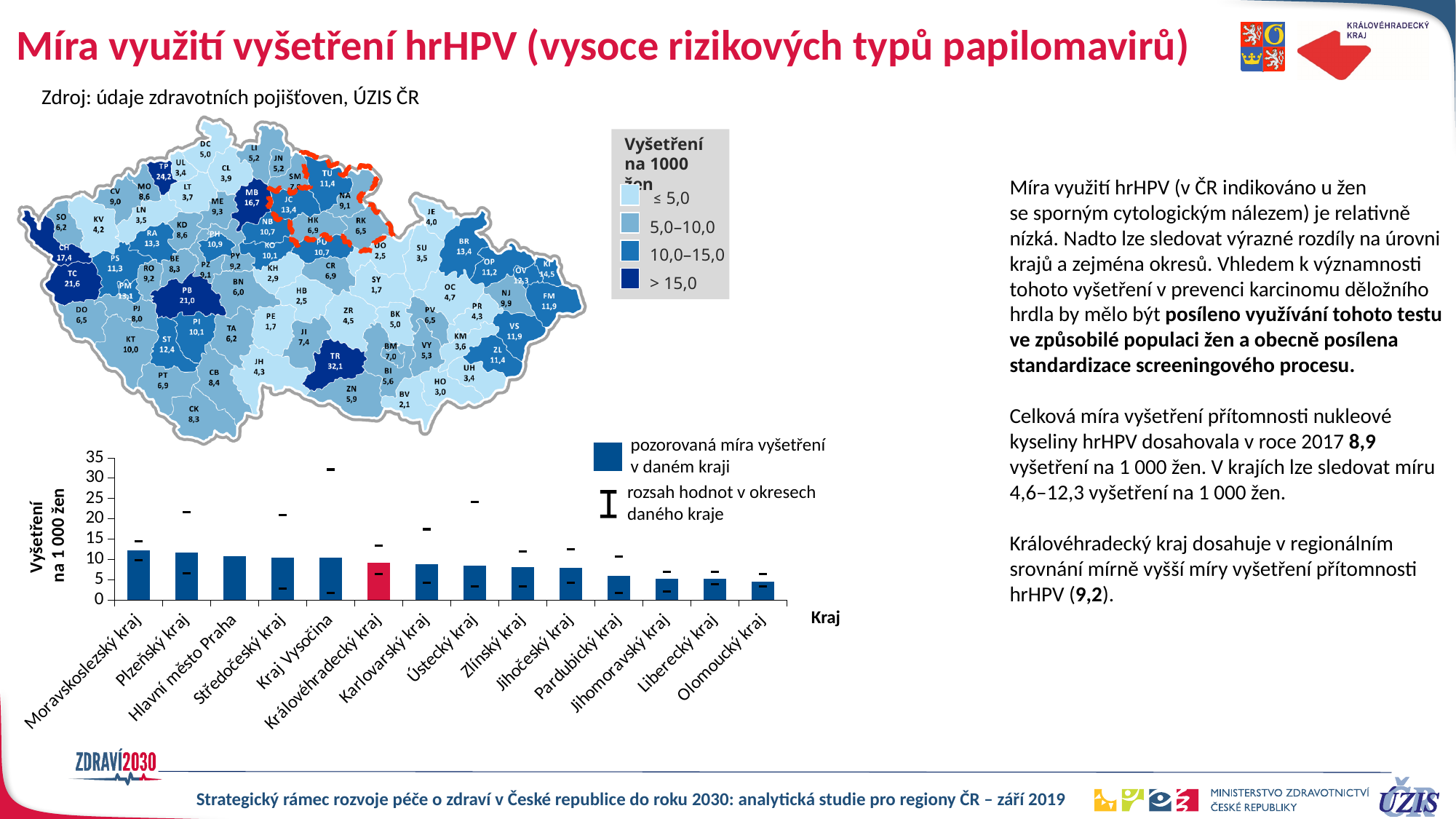
On the map, what is the value shown for district TR? 32,1 In the bar chart, is the value for Pardubický kraj greater or less than 10? less In the bar chart, is the value for Hlavní město Praha greater or less than 5? greater In the bar chart, is the value for Moravskoslezský kraj greater or less than 10? greater In the bar chart, which is larger: the value for Moravskoslezský kraj or for Pardubický kraj? Moravskoslezský kraj How many regions (kraje) are shown on the x axis of the bar chart? 14 Do the bar values rise or fall from left to right along the x axis of the bar chart? fall In the bar chart, which region has the highest observed examination rate? Moravskoslezský kraj What kind of chart is shown at the bottom left of the slide? bar chart What is the y-axis label of the bar chart? Vyšetření na 1 000 žen In the bar chart, which region has the lowest observed examination rate? Olomoucký kraj Which bar in the bar chart is highlighted in red? Královéhradecký kraj